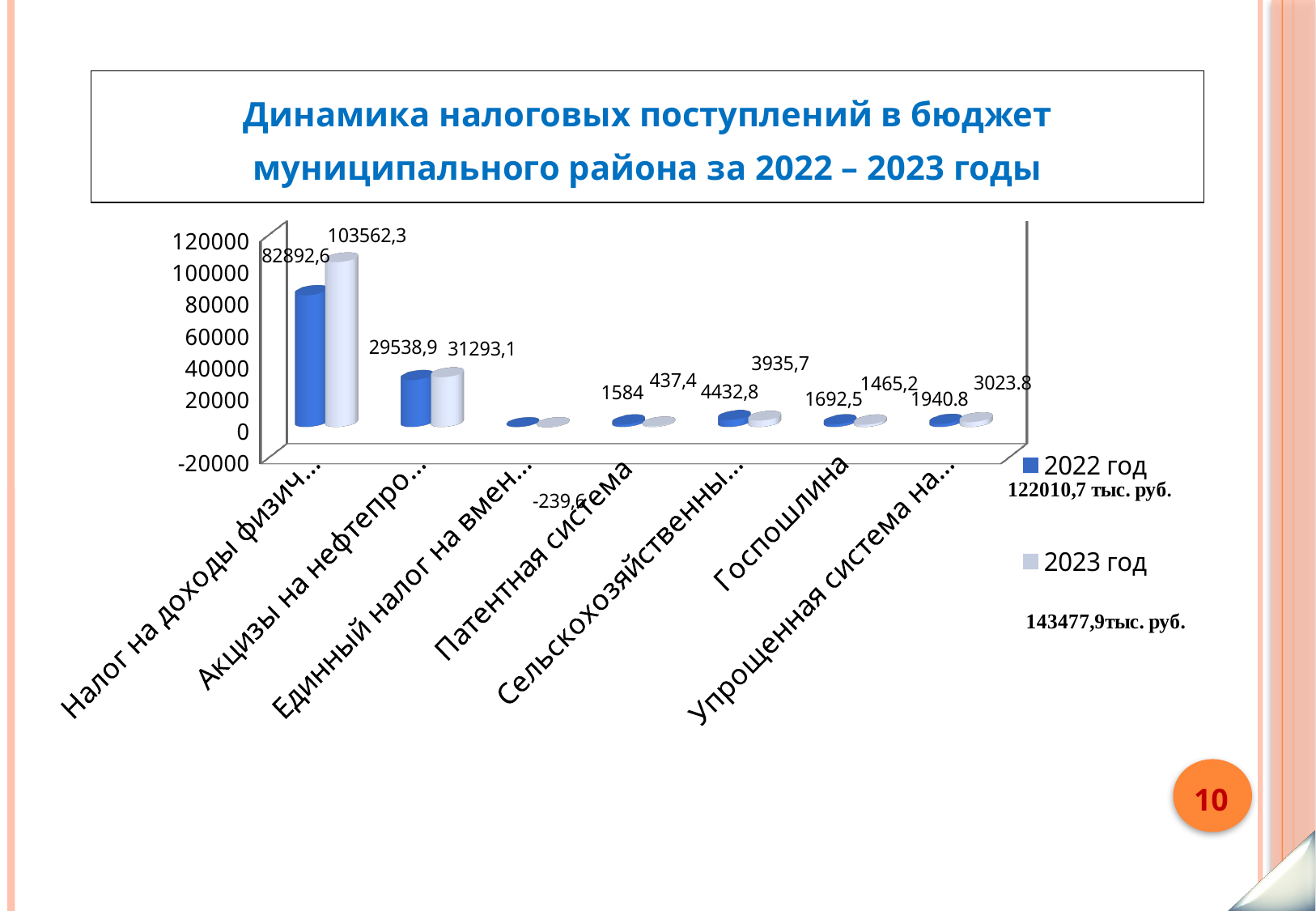
What is the 2023 год value for Госпошлина? 1465,2 What is the 2022 год value for Патентная система? 1584 What is the 2022 год value for Налог на доходы физич...? 82892,6 How many series does the legend list? 2 How many categories are shown on the x axis? 7 What is the 2023 год value for Акцизы на нефтепро...? 31293,1 Which category has the highest 2023 год value? Налог на доходы физич... What is the difference between the 2022 год and 2023 год values for Патентная система? 1146,6 What is the 2023 год value for Налог на доходы физич...? 103562,3 What kind of chart is shown on the slide? Bar chart What is the difference between the 2023 год and 2022 год values for Налог на доходы физич...? 20669,7 Which is larger for Сельскохозяйственны...: the 2022 год value or the 2023 год value? 2022 год